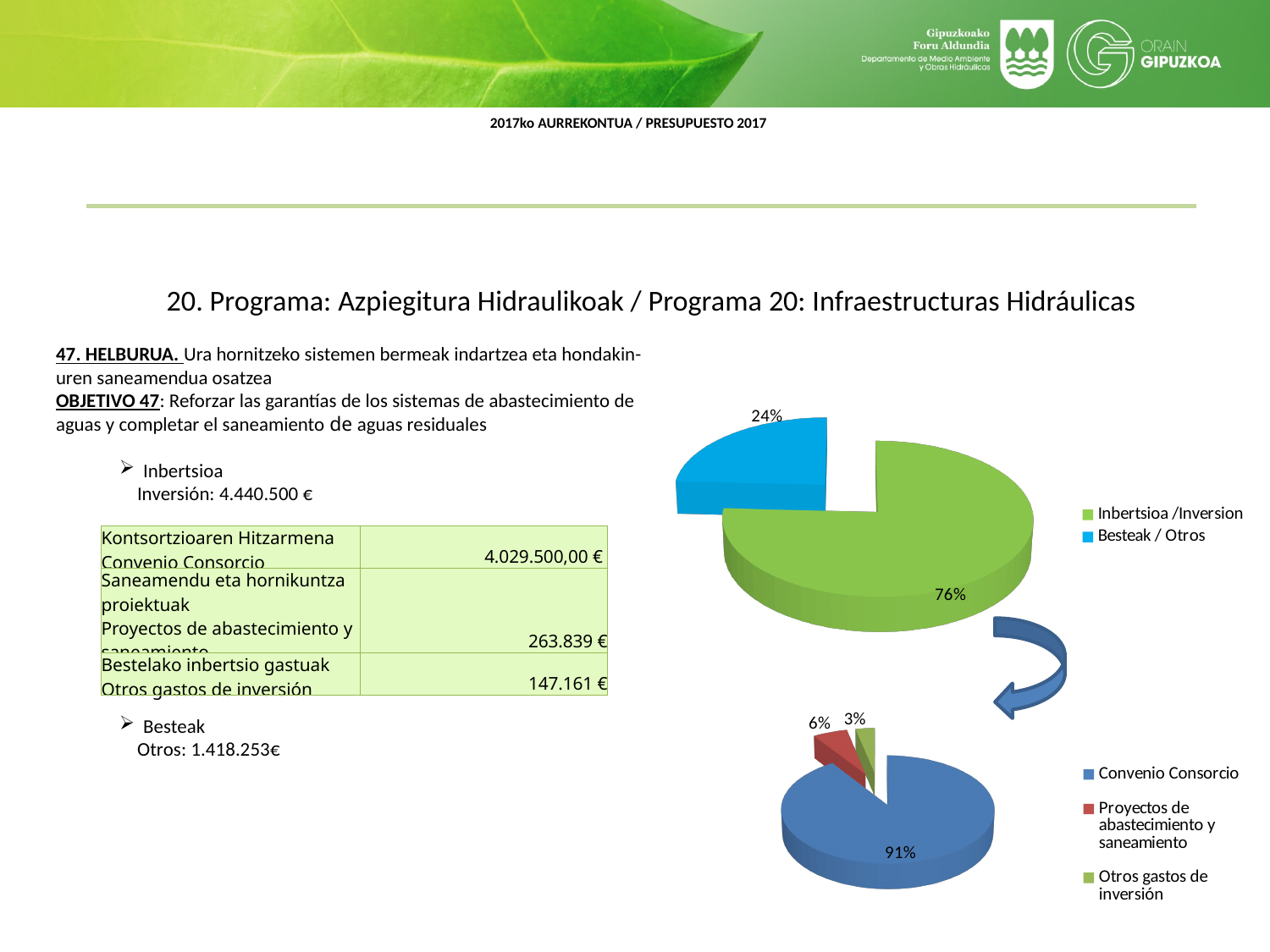
What type of chart is the upper chart on the right of the slide? Pie chart In the lower pie chart, what share does Otros gastos de inversión have? 3% How many slices does the lower pie chart have? 3 In the upper pie chart, which slice is the largest? Inbertsioa /Inversion In the lower pie chart, which slice is the smallest? Otros gastos de inversión In the lower pie chart, what share does Convenio Consorcio have? 91% In the upper pie chart, what share does Besteak / Otros have? 24% How many entries does the legend of the upper pie chart list? 2 In the upper pie chart, what is the difference in percentage points between Inbertsioa /Inversion and Besteak / Otros? 52 In the lower pie chart, which is larger: Proyectos de abastecimiento y saneamiento or Otros gastos de inversión? Proyectos de abastecimiento y saneamiento